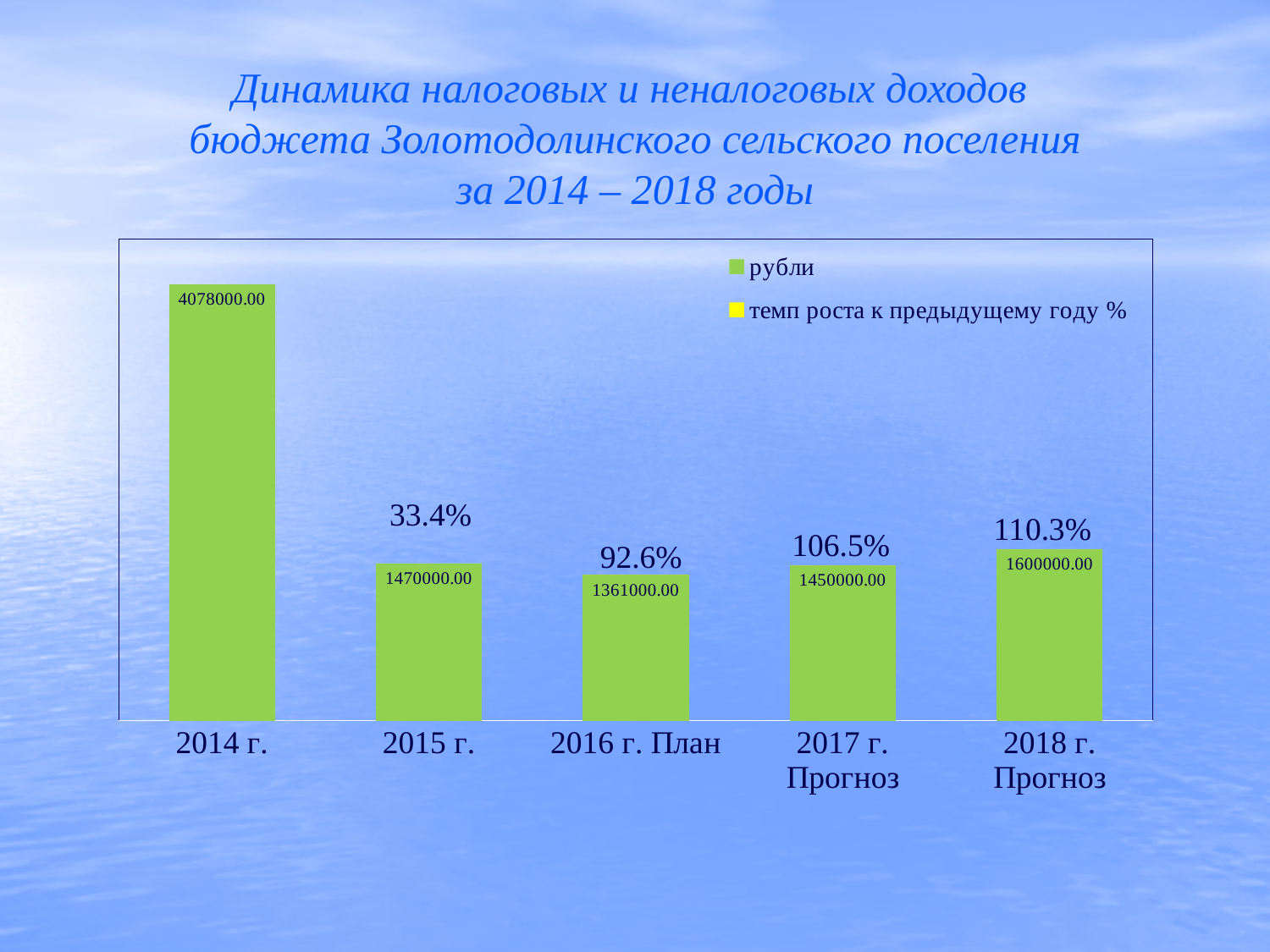
What is the difference in rubles between 2018 г. Прогноз and 2017 г. Прогноз? 150000.00 How many series does the legend list? 2 Which is larger in rubles: 2015 г. or 2017 г. Прогноз? 2015 г. Which year has the lowest value in rubles? 2016 г. План What kind of chart is shown on the slide? bar chart What is the value in rubles for 2014 г.? 4078000.00 What is the growth rate to the previous year shown for 2018 г. Прогноз? 110.3% Which year has the highest value in rubles? 2014 г. What is the value in rubles for 2016 г. План? 1361000.00 How many years (categories) are shown on the x axis? 5 What is the difference in rubles between 2014 г. and 2015 г.? 2608000.00 What is the growth rate to the previous year (темп роста к предыдущему году %) shown for 2015 г.? 33.4%